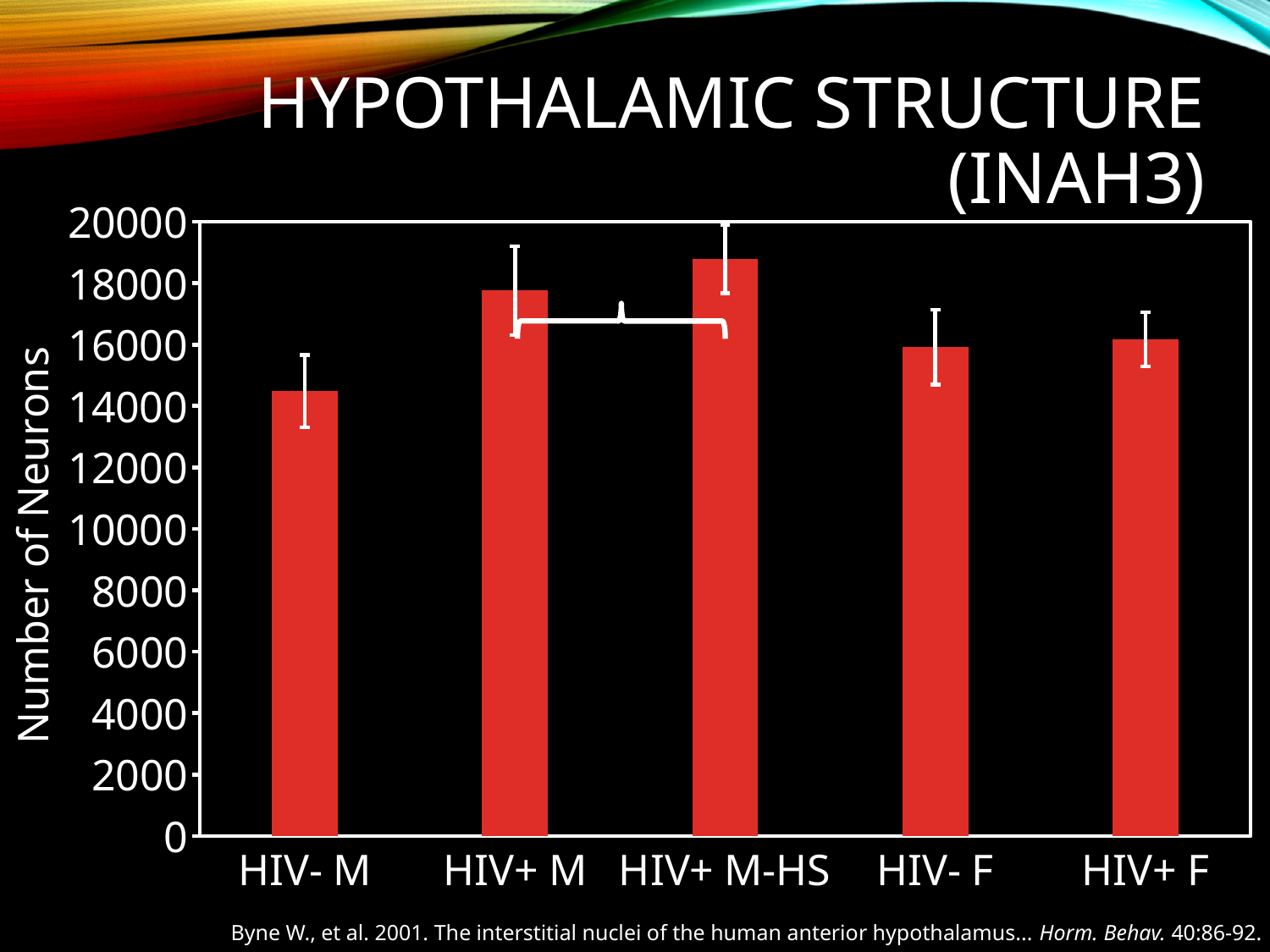
Which is larger, the value for HIV+ M or the value for HIV- M? HIV+ M Is the value for HIV+ M-HS greater or less than 18000? greater Which is larger, the value for HIV+ M or the value for HIV- F? HIV+ M Is the value for HIV- F greater or less than 14000? greater Is the value for HIV+ F greater or less than 18000? less How many categories are plotted on the x axis? 5 Which category has the lowest number of neurons? HIV- M Which category has the highest number of neurons? HIV+ M-HS What kind of chart is shown on the slide? bar chart What is the label of the y axis? Number of Neurons